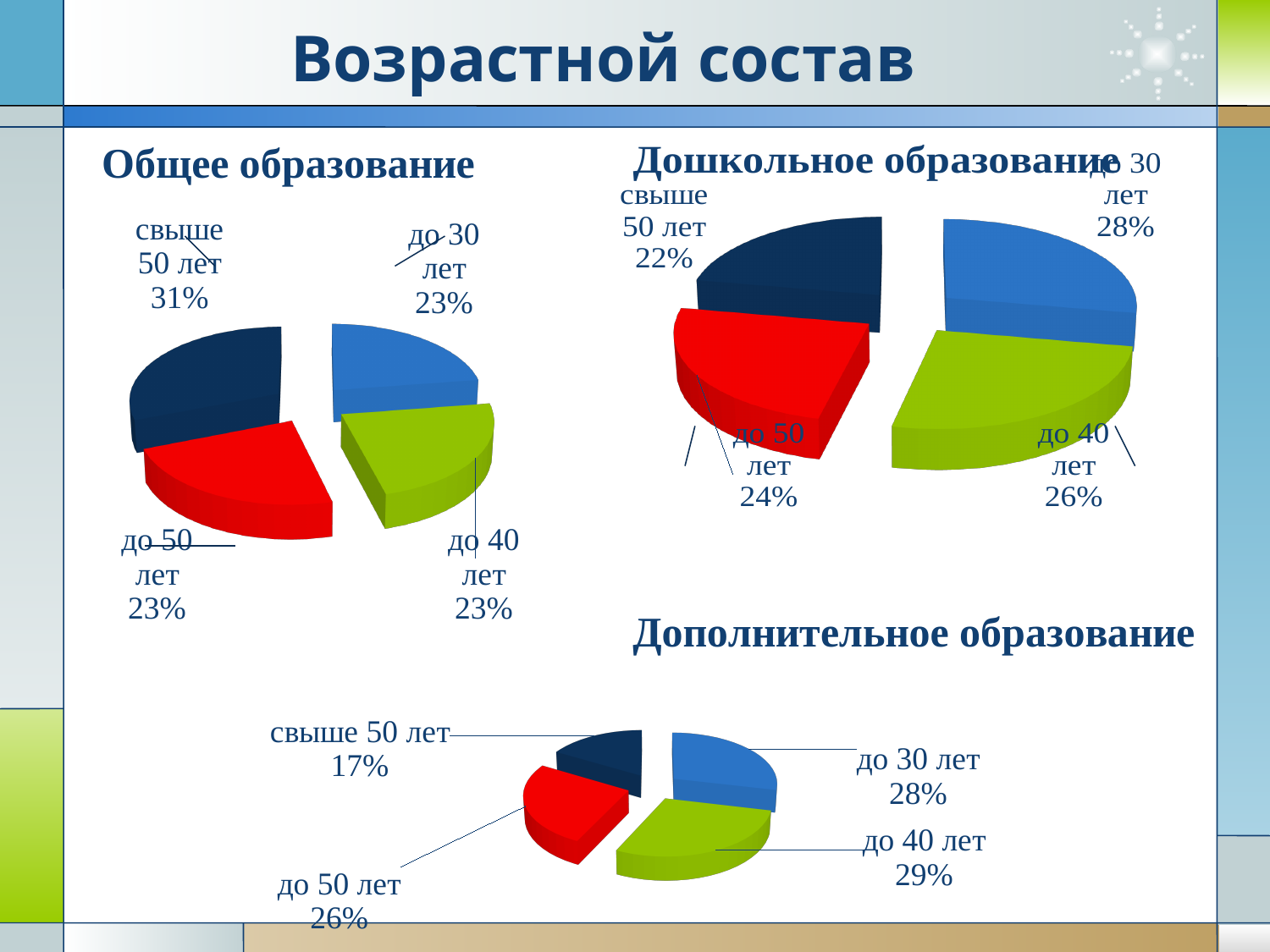
On the "Общее образование" chart, what is the difference between "свыше 50 лет" and "до 30 лет"? 8 percentage points On the "Дошкольное образование" chart, which category has the smallest share? свыше 50 лет On the "Дополнительное образование" chart, which category has the largest share? до 40 лет What type of chart is used for "Общее образование"? Pie chart On the "Дополнительное образование" chart, what share is "свыше 50 лет"? 17% How many charts are shown on the slide? 3 On the "Общее образование" chart, which category has the largest share? свыше 50 лет On the "Общее образование" chart, what share is "свыше 50 лет"? 31% On the "Дошкольное образование" chart, which is larger: "до 30 лет" or "до 40 лет"? до 30 лет How many slices does the "Дополнительное образование" chart have? 4 On the "Дошкольное образование" chart, what share is "до 50 лет"? 24% On the "Дополнительное образование" chart, what is the difference between "до 40 лет" and "свыше 50 лет"? 12 percentage points